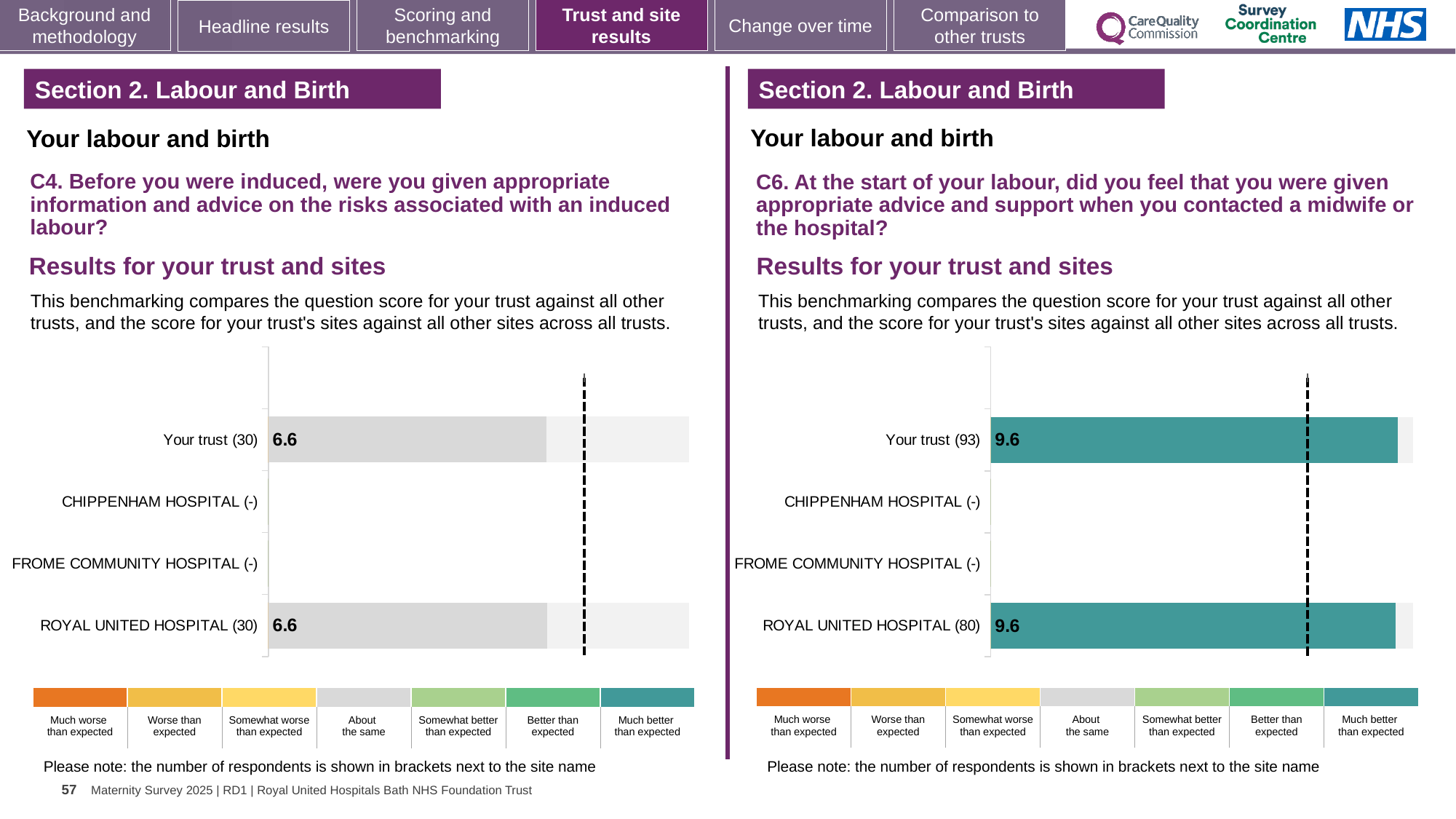
On the right chart (C6), what is the score for Your trust? 9.6 On the right chart (C6), which benchmark category does the colour of the Your trust bar correspond to in the legend? Much better than expected On the left chart (C4), what is the score for Your trust? 6.6 How many site or trust categories are listed on the left chart (C4)? 4 On the left chart (C4), which benchmark category does the colour of the Your trust bar correspond to in the legend? About the same What kind of chart is used on the right (C6)? Bar chart Which is larger: the score for Your trust on the right chart (C6) or the score for Your trust on the left chart (C4)? Your trust on the right chart (C6) On the left chart (C4), what is the score for ROYAL UNITED HOSPITAL? 6.6 On the right chart (C6), what is the score for ROYAL UNITED HOSPITAL? 9.6 On the right chart (C6), how many respondents are shown in brackets for ROYAL UNITED HOSPITAL? 80 On the left chart (C4), how many respondents are shown in brackets for Your trust? 30 On the left chart (C4), what is the difference between the score for Your trust and the score for ROYAL UNITED HOSPITAL? 0